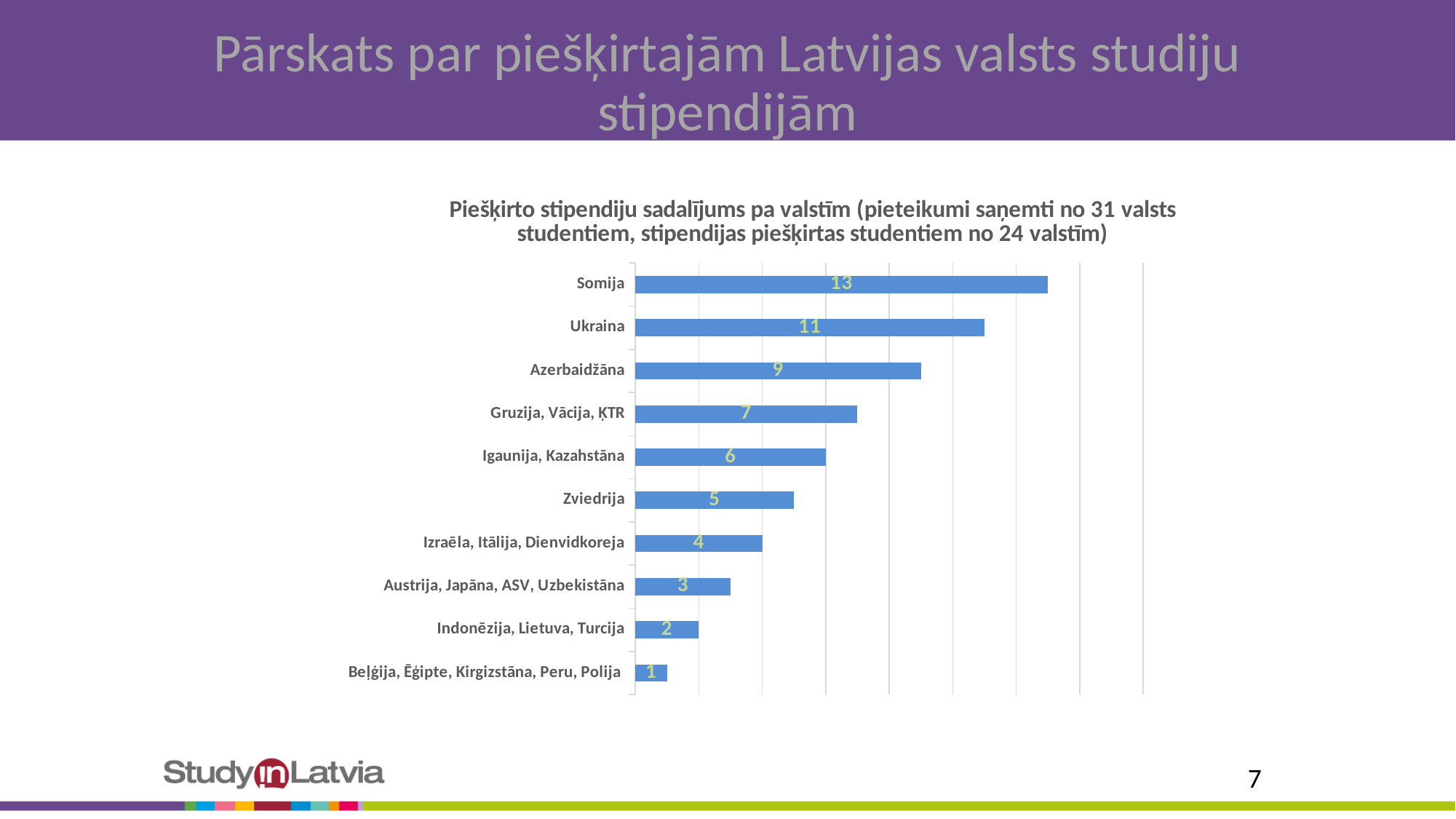
What colour are the bars in the chart? Blue What value is shown for Somija? 13 What value is shown for Ukraina? 11 What is the difference between the values for Somija and Ukraina? 2 Which category has the highest value? Somija What value is shown for Zviedrija? 5 What is the difference between the values for Azerbaidžāna and Zviedrija? 4 Which category has the lowest value? Beļģija, Ēģipte, Kirgizstāna, Peru, Polija What kind of chart is shown on the slide? Bar chart How many categories are shown in the chart? 10 Which has a larger value, Gruzija, Vācija, ĶTR or Izraēla, Itālija, Dienvidkoreja? Gruzija, Vācija, ĶTR What value is shown for Igaunija, Kazahstāna? 6